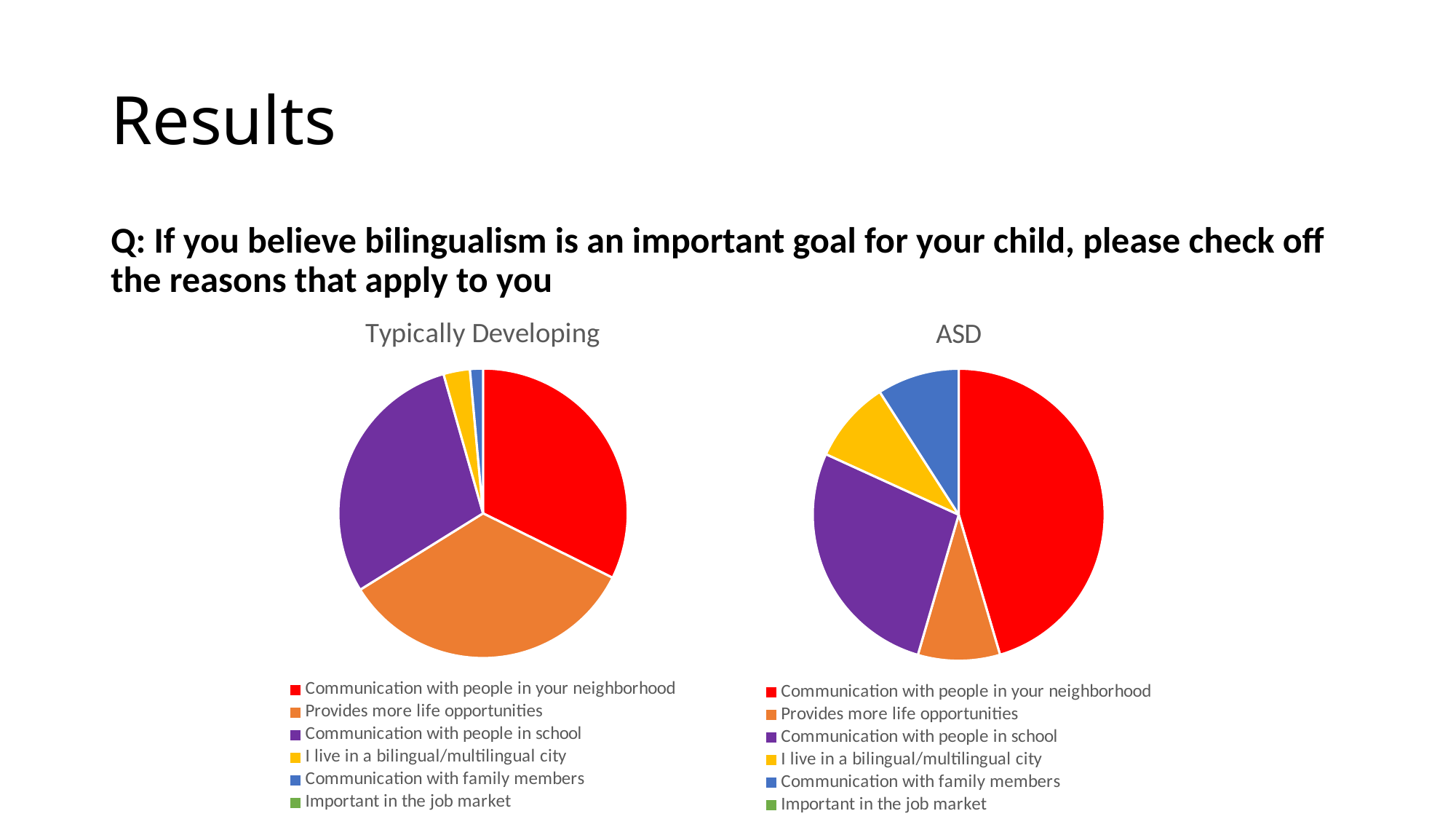
In the 'Typically Developing' chart, which slice is larger: 'Communication with people in school' or 'I live in a bilingual/multilingual city'? Communication with people in school In the 'ASD' chart, which category has the largest slice? Communication with people in your neighborhood In the 'Typically Developing' chart, which colour represents 'Provides more life opportunities'? orange What is the title of the pie chart on the right of the slide? ASD How many categories does the legend of the 'ASD' chart list? 6 In the 'ASD' chart, which slice is larger: 'Communication with people in school' or 'Provides more life opportunities'? Communication with people in school How many categories does the legend of the 'Typically Developing' chart list? 6 In the 'Typically Developing' chart, which slice is larger: 'Provides more life opportunities' or 'Communication with family members'? Provides more life opportunities What kind of chart is the 'Typically Developing' chart? pie chart What kind of chart is the 'ASD' chart? pie chart